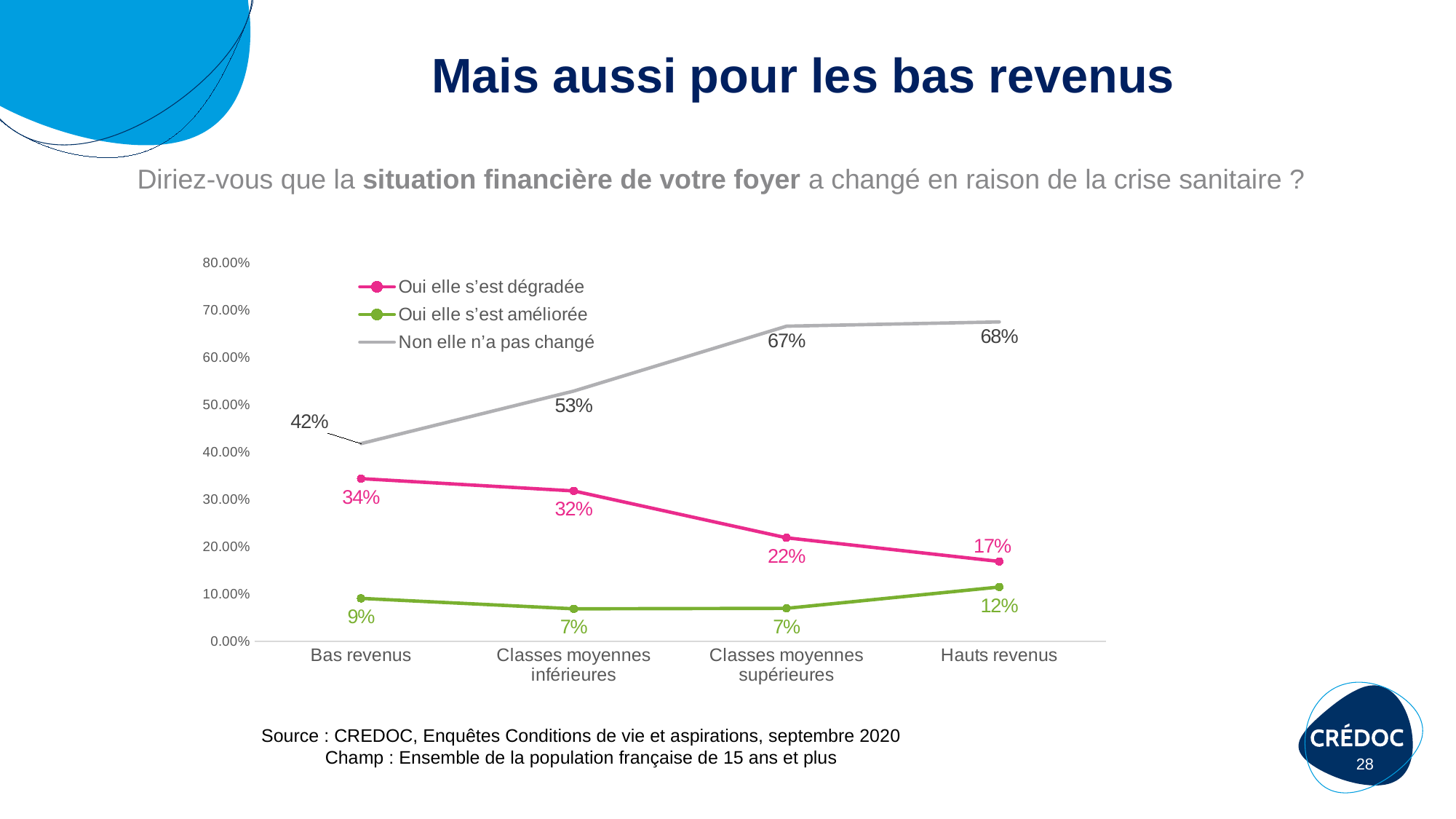
Does the 'Non elle n'a pas changé' series rise or fall from Bas revenus to Hauts revenus? rise Which category has the lowest value for 'Non elle n'a pas changé'? Bas revenus What is the value for 'Oui elle s'est améliorée' for Hauts revenus? 12% What is the value for 'Non elle n'a pas changé' for Classes moyennes supérieures? 67% How many series does the legend list? 3 Which category has the highest value for 'Oui elle s'est dégradée'? Bas revenus Which is larger for Classes moyennes inférieures: 'Oui elle s'est dégradée' or 'Oui elle s'est améliorée'? Oui elle s'est dégradée What is the value for 'Oui elle s'est dégradée' for Bas revenus? 34% How many categories are shown on the x axis? 4 What is the difference between the 'Oui elle s'est dégradée' values for Bas revenus and Hauts revenus? 17% What colour is the line for 'Oui elle s'est améliorée'? green What kind of chart is shown on the slide? line chart